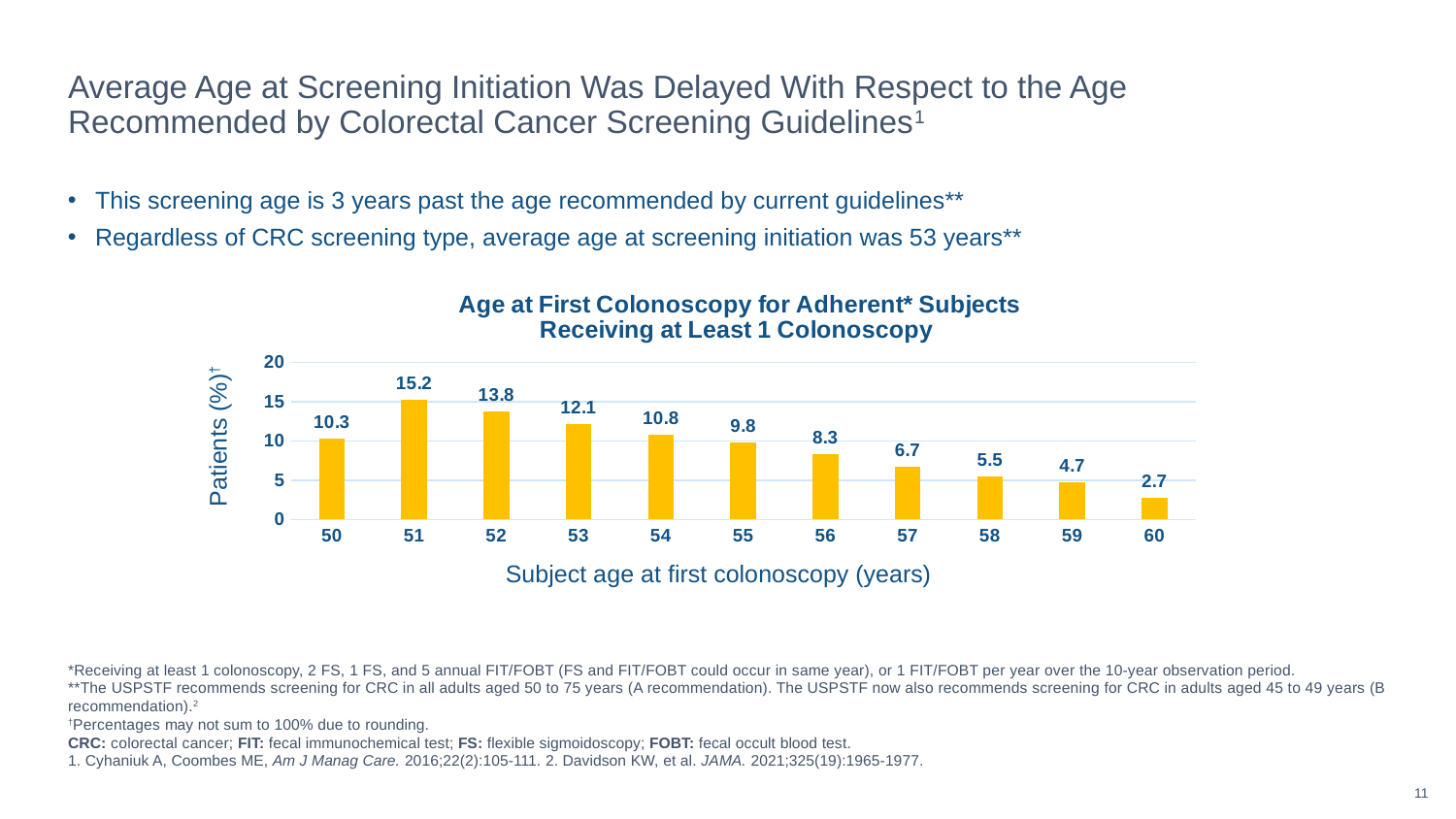
How many subject age categories are shown on the x axis? 11 Is the value for age 56 greater or less than 10? less What is the value shown for subject age 55 at first colonoscopy? 9.8 Which subject age at first colonoscopy has the lowest percentage of patients? 60 What is the difference between the values for age 53 and age 57? 5.4 From age 51 to age 60, do the values rise or fall along the x axis? Fall What percentage of patients had their first colonoscopy at age 60? 2.7 Which subject age at first colonoscopy has the highest percentage of patients? 51 What percentage of patients had their first colonoscopy at age 51? 15.2 Which has a larger value, age 52 or age 54? 52 What kind of chart is used to show age at first colonoscopy? Bar chart What is the difference between the values for age 51 and age 50? 4.9